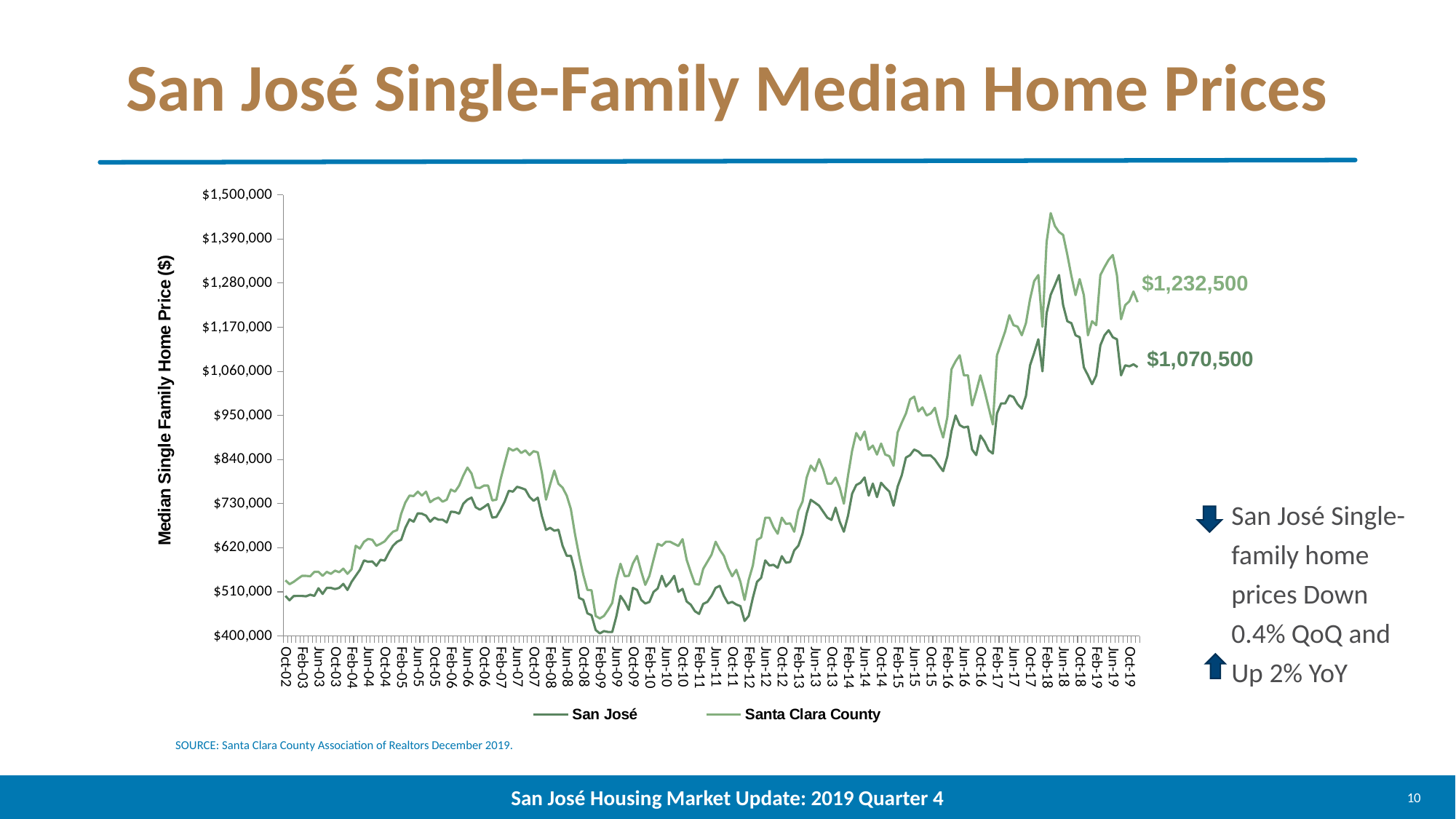
At the end of the series, which is higher: San José or Santa Clara County? Santa Clara County Is the San José value around Feb-09 greater or less than $510,000? less What is the title of the vertical axis? Median Single Family Home Price ($) Is the peak Santa Clara County value around Jun-18 greater or less than $1,390,000? greater How many series does the legend list? 2 Overall, do the San José median home prices rise or fall from Oct-02 to Oct-19? rise What is the latest labelled median home price for San José? $1,070,500 Is the San José value at Oct-02 greater or less than $620,000? less What is the latest labelled median home price for Santa Clara County? $1,232,500 What source is cited for the chart data? Santa Clara County Association of Realtors December 2019 What is the difference between the latest labelled Santa Clara County value and the latest labelled San José value? $162,000 What kind of chart is shown on the slide? line chart